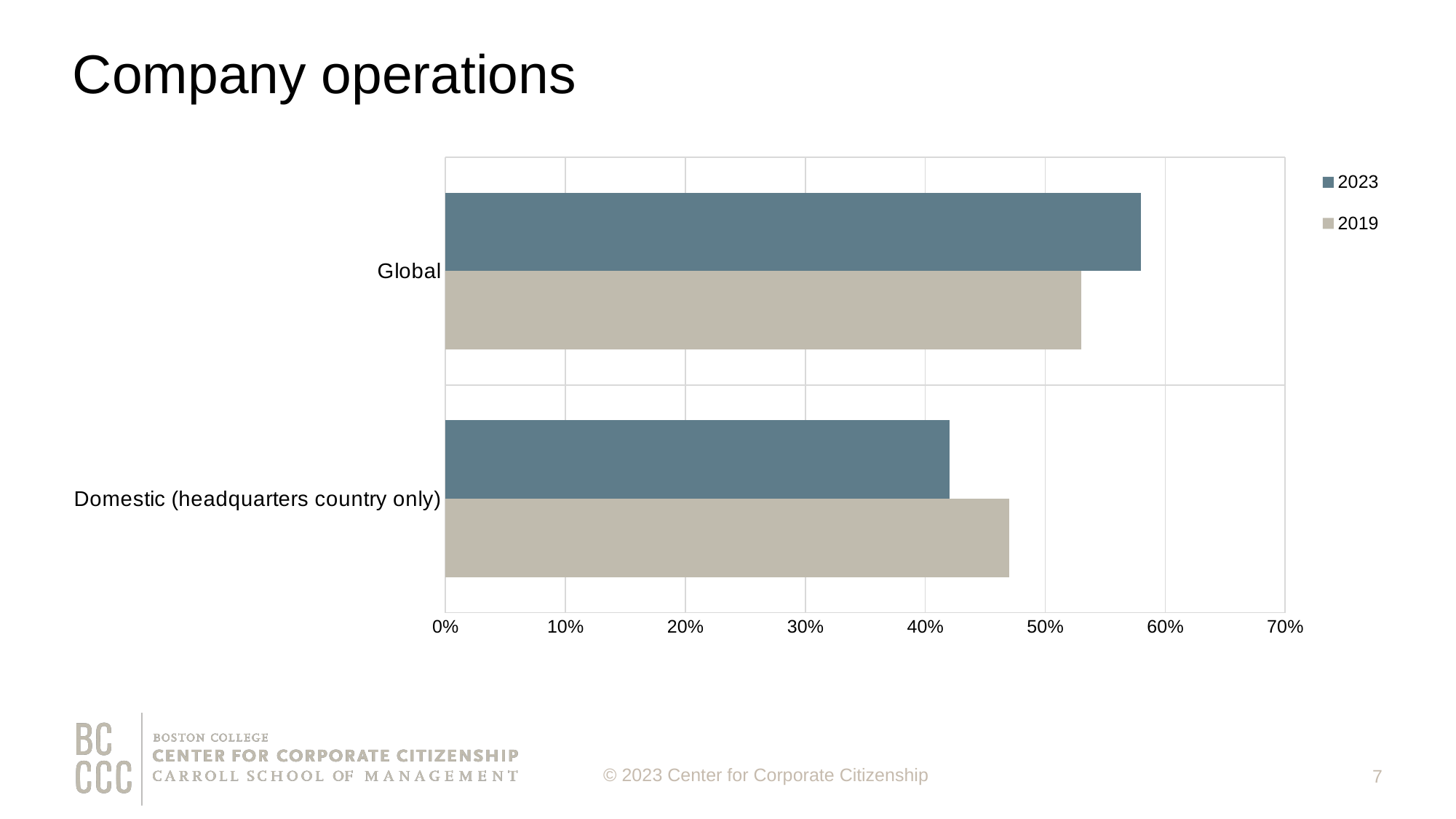
What kind of chart is shown on the slide? Bar chart For Domestic (headquarters country only), which year has the larger value, 2023 or 2019? 2019 Is the 2023 value for Domestic (headquarters country only) greater or less than 50%? less How many categories are shown on the chart? 2 In 2023, which category has the higher value, Global or Domestic (headquarters country only)? Global For Global, which year has the larger value, 2023 or 2019? 2023 Is the 2019 value for Domestic (headquarters country only) greater or less than 40%? greater Is the 2023 value for Global greater or less than 60%? less What is the title of the slide containing the chart? Company operations How many series does the legend list? 2 Which series does the legend list first? 2023